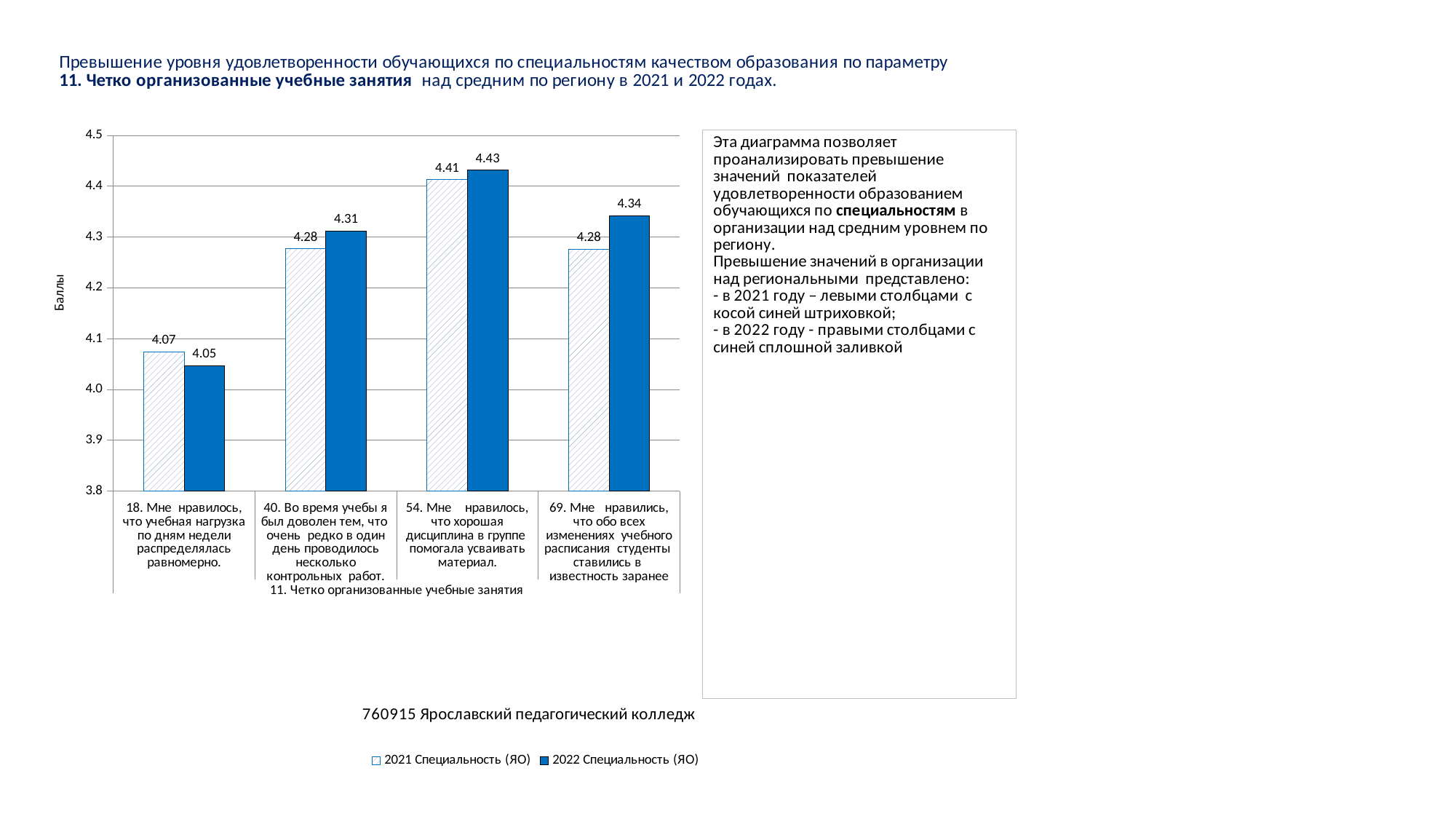
What is the 2022 Специальность (ЯО) value for category 40 (Во время учебы я был доволен тем, что очень редко в один день проводилось несколько контрольных работ)? 4.31 For category 18, which series has the larger value: 2021 Специальность (ЯО) or 2022 Специальность (ЯО)? 2021 Специальность (ЯО) Which category has the lowest 2021 Специальность (ЯО) value? 18. Мне нравилось, что учебная нагрузка по дням недели распределялась равномерно. What is the difference between the 2022 and 2021 values for category 69? 0.06 How many series does the chart legend list? 2 What is the 2022 Специальность (ЯО) value for category 69 (Мне нравились, что обо всех изменениях учебного расписания студенты ставились в известность заранее)? 4.34 What is the label of the vertical axis of the chart? Баллы Is the 2021 Специальность (ЯО) value for category 54 greater or less than 4.3? greater How many categories are shown on the x axis of the chart? 4 Which category has the highest 2022 Специальность (ЯО) value? 54. Мне нравилось, что хорошая дисциплина в группе помогала усваивать материал. What is the 2021 Специальность (ЯО) value for category 18 (Мне нравилось, что учебная нагрузка по дням недели распределялась равномерно)? 4.07 What kind of chart is shown on the slide? Bar chart